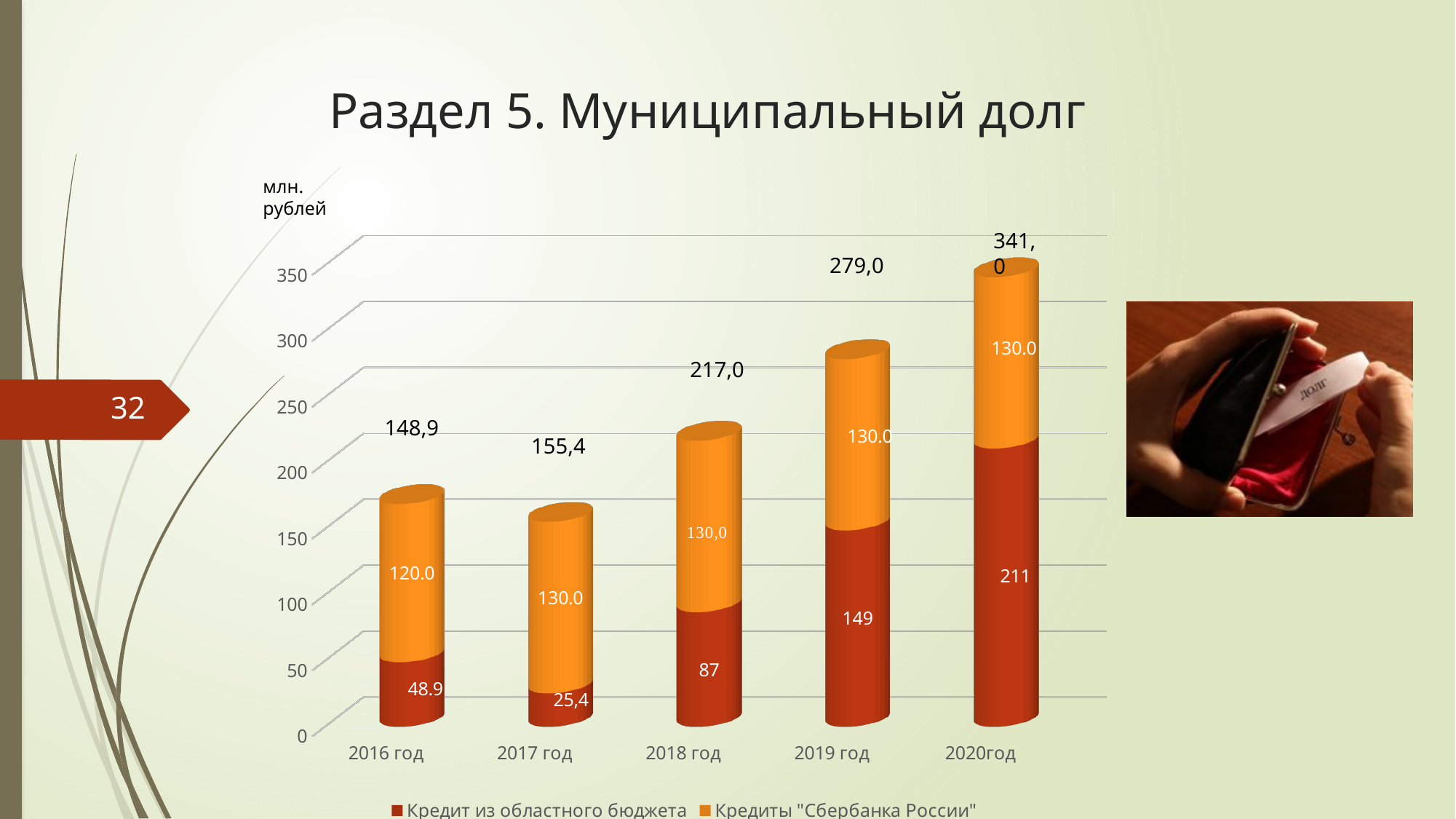
What is the total municipal debt shown for 2020год? 341,0 What is the value of "Кредит из областного бюджета" for 2019 год? 149 How many years are shown on the x axis? 5 Which year has the highest total municipal debt? 2020год What type of chart is shown on the slide? bar chart Which year has the lowest value for "Кредит из областного бюджета"? 2017 год Does the total municipal debt rise or fall from 2017 год to 2020год? rise How many series does the legend list? 2 What is the value of "Кредит из областного бюджета" for 2016 год? 48.9 What is the total shown above the bar for 2018 год? 217,0 What is the difference between the "Кредит из областного бюджета" values for 2020год and 2019 год? 62 What is the value of "Кредиты "Сбербанка России"" for 2017 год? 130.0